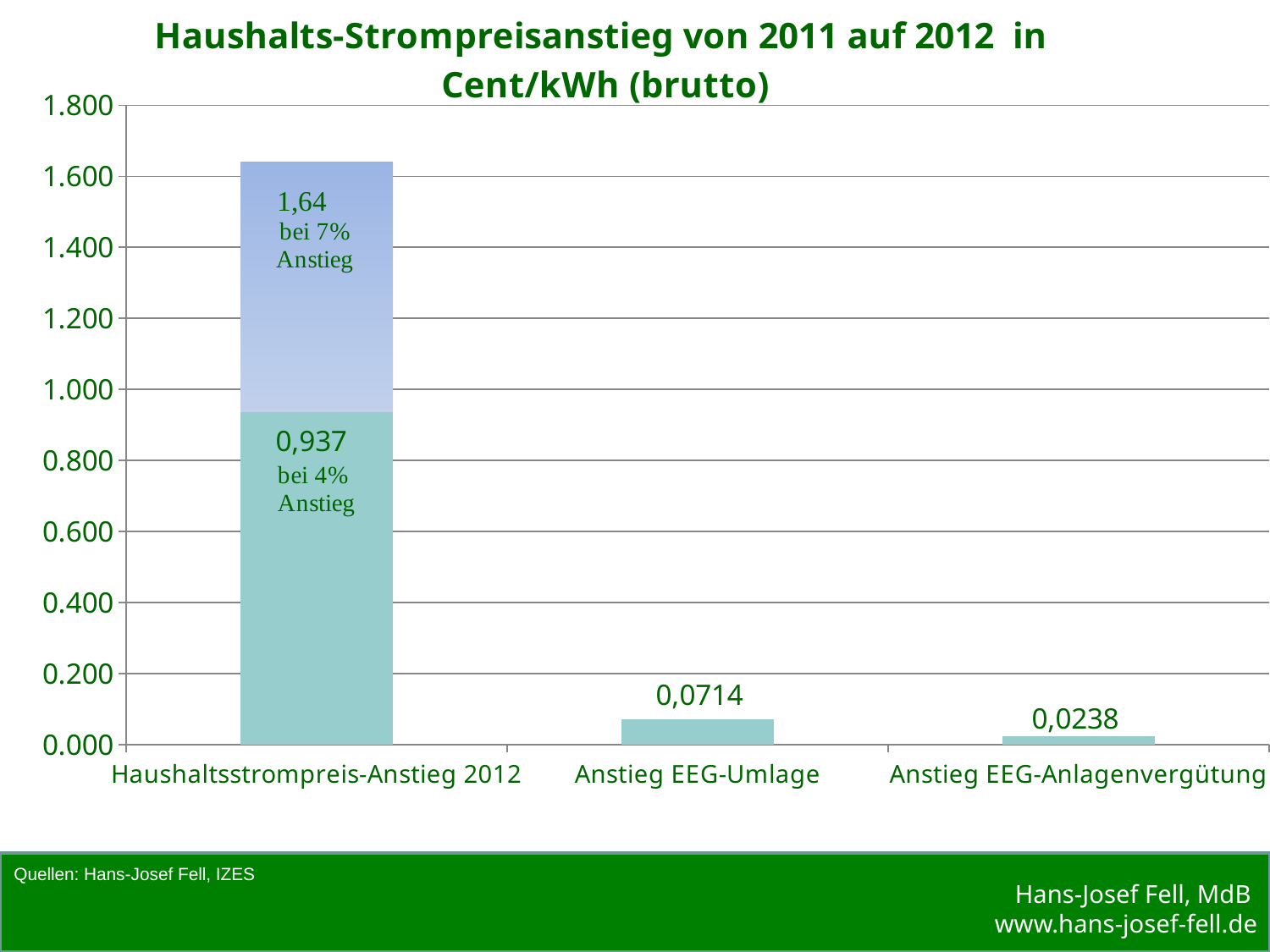
Which category has the lowest bar? Anstieg EEG-Anlagenvergütung Is the top of the Haushaltsstrompreis-Anstieg 2012 bar greater or less than 1.000? greater What kind of chart is shown on the slide? bar chart Which category has the highest bar? Haushaltsstrompreis-Anstieg 2012 What is the value shown for Anstieg EEG-Anlagenvergütung? 0,0238 What is the value shown for Anstieg EEG-Umlage? 0,0714 How many categories are shown on the x axis? 3 Which is larger, Anstieg EEG-Umlage or Anstieg EEG-Anlagenvergütung? Anstieg EEG-Umlage What value is labelled on the Haushaltsstrompreis-Anstieg 2012 bar for the 4% Anstieg portion? 0,937 What is the difference between the values for Anstieg EEG-Umlage and Anstieg EEG-Anlagenvergütung? 0,0476 What value is labelled on the Haushaltsstrompreis-Anstieg 2012 bar for the 7% Anstieg portion? 1,64 What is the title of the chart? Haushalts-Strompreisanstieg von 2011 auf 2012 in Cent/kWh (brutto)